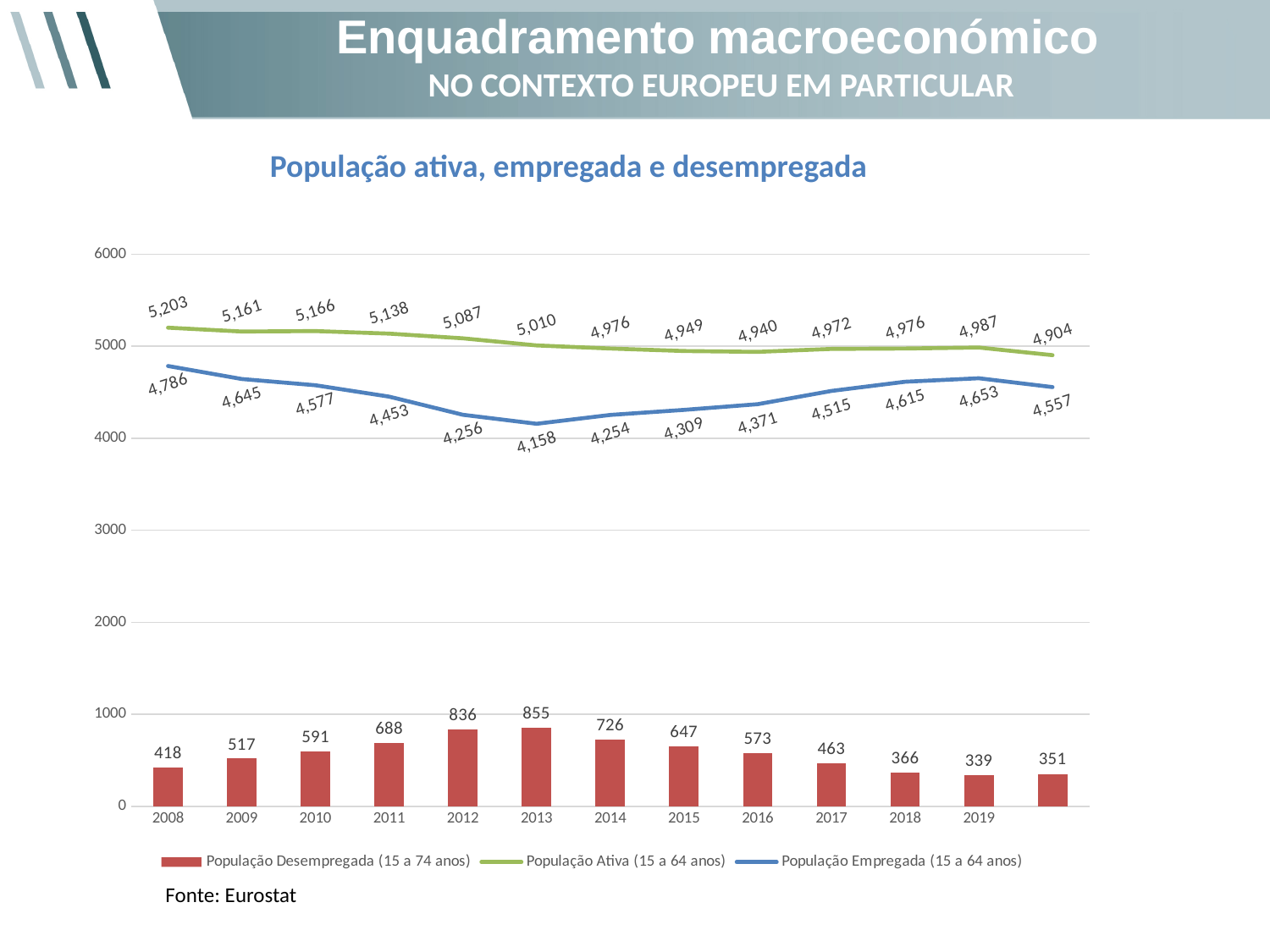
Is the value for População Empregada (15 a 64 anos) in 2011 greater or less than 4000? greater In which year is População Desempregada (15 a 74 anos) highest? 2013 How many series does the legend list? 3 What kind of chart is used to show População Desempregada (15 a 74 anos)? bar chart Which is larger: População Desempregada in 2012 or in 2016? 2012 What is the value of População Empregada (15 a 64 anos) in 2013? 4,158 Does População Desempregada (15 a 74 anos) rise or fall from 2013 to 2019? fall What is the value of População Desempregada (15 a 74 anos) in 2013? 855 What is the value of População Ativa (15 a 64 anos) in 2008? 5,203 In which year is População Empregada (15 a 64 anos) lowest? 2013 What is the source cited below the chart? Eurostat What is the difference between População Ativa and População Empregada in 2019? 334